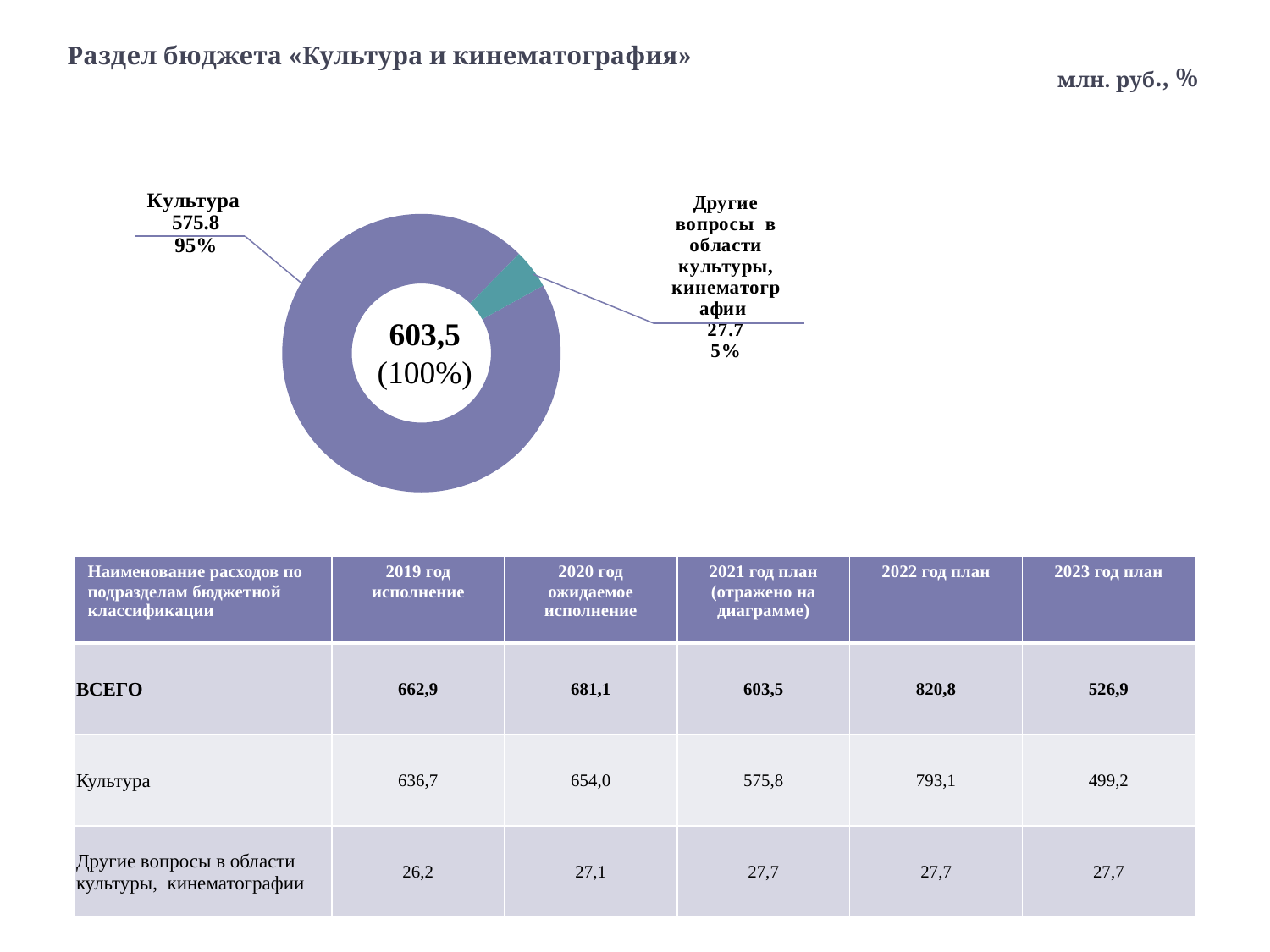
How many slices does the doughnut chart have? 2 Which slice of the doughnut chart is the smallest? Другие вопросы в области культуры, кинематографии What share of the doughnut chart does the Культура slice represent? 95% What total value is shown in the centre of the doughnut chart? 603,5 What share of the doughnut chart does the slice Другие вопросы в области культуры, кинематографии represent? 5% What value is shown for the Культура slice of the doughnut chart? 575.8 Which slice of the doughnut chart is the largest? Культура What colour is the Культура slice in the doughnut chart? purple What is the difference between the Культура slice (575.8) and the Другие вопросы slice (27.7) in the doughnut chart? 548.1 Which is larger in the doughnut chart: Культура or Другие вопросы в области культуры, кинематографии? Культура What value is shown for the slice Другие вопросы в области культуры, кинематографии? 27.7 What kind of chart is shown on the slide? doughnut (pie) chart